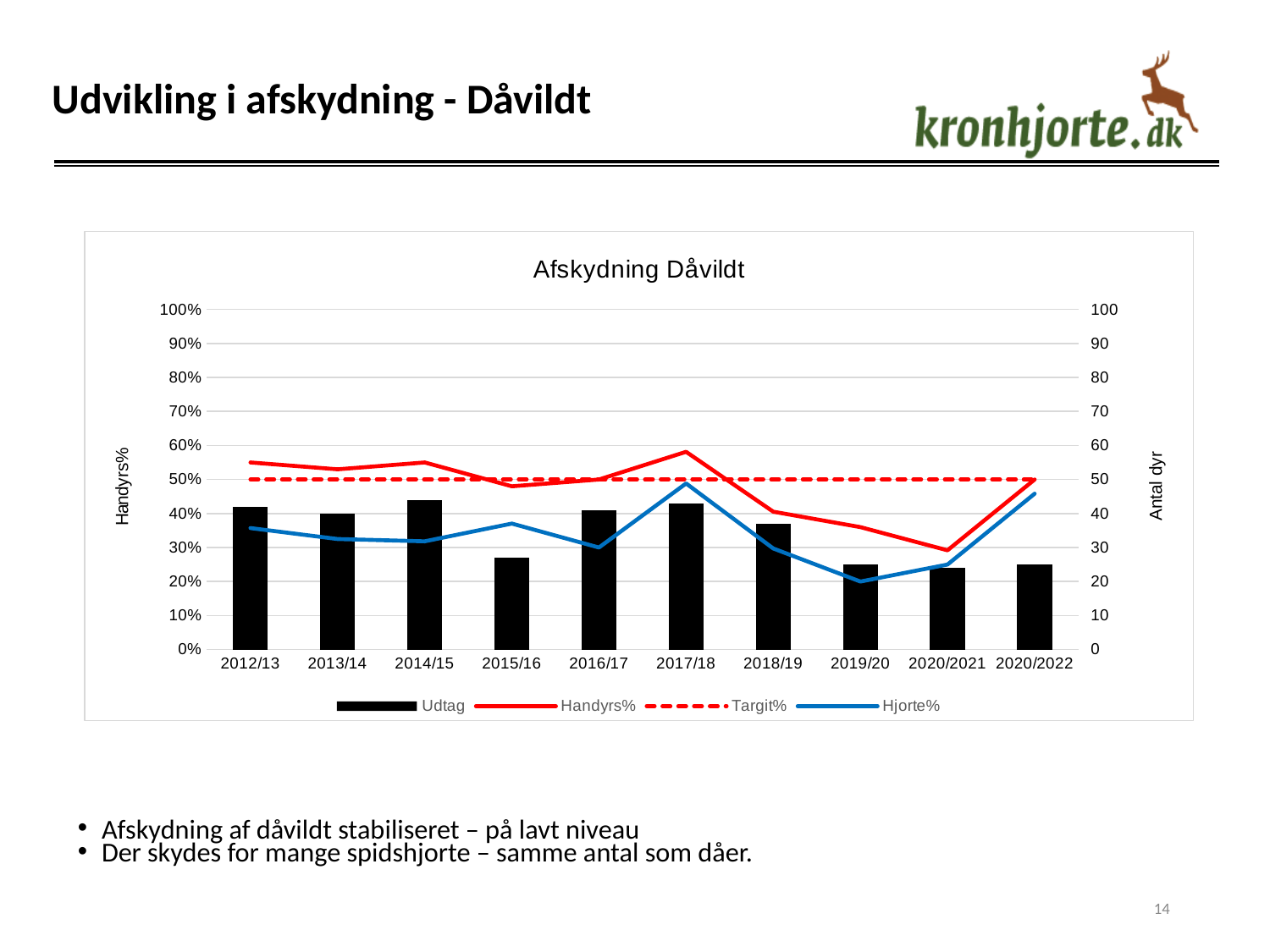
What kind of chart is shown on the slide? Combined bar and line chart In which season is the Handyrs% line at its lowest? 2020/2021 Is the Udtag bar for 2014/15 greater or less than 40? greater How many seasons are shown on the x axis of the chart? 10 What is the title of the chart? Afskydning Dåvildt Is the Hjorte% value for 2019/20 greater or less than 30%? less Is the Udtag bar for 2015/16 greater or less than 30? less How many series does the chart legend list? 4 What value does the Targit% line sit at throughout the chart? 50% In which season is the Hjorte% line at its lowest? 2019/20 Which is larger in 2012/13, Handyrs% or Hjorte%? Handyrs%